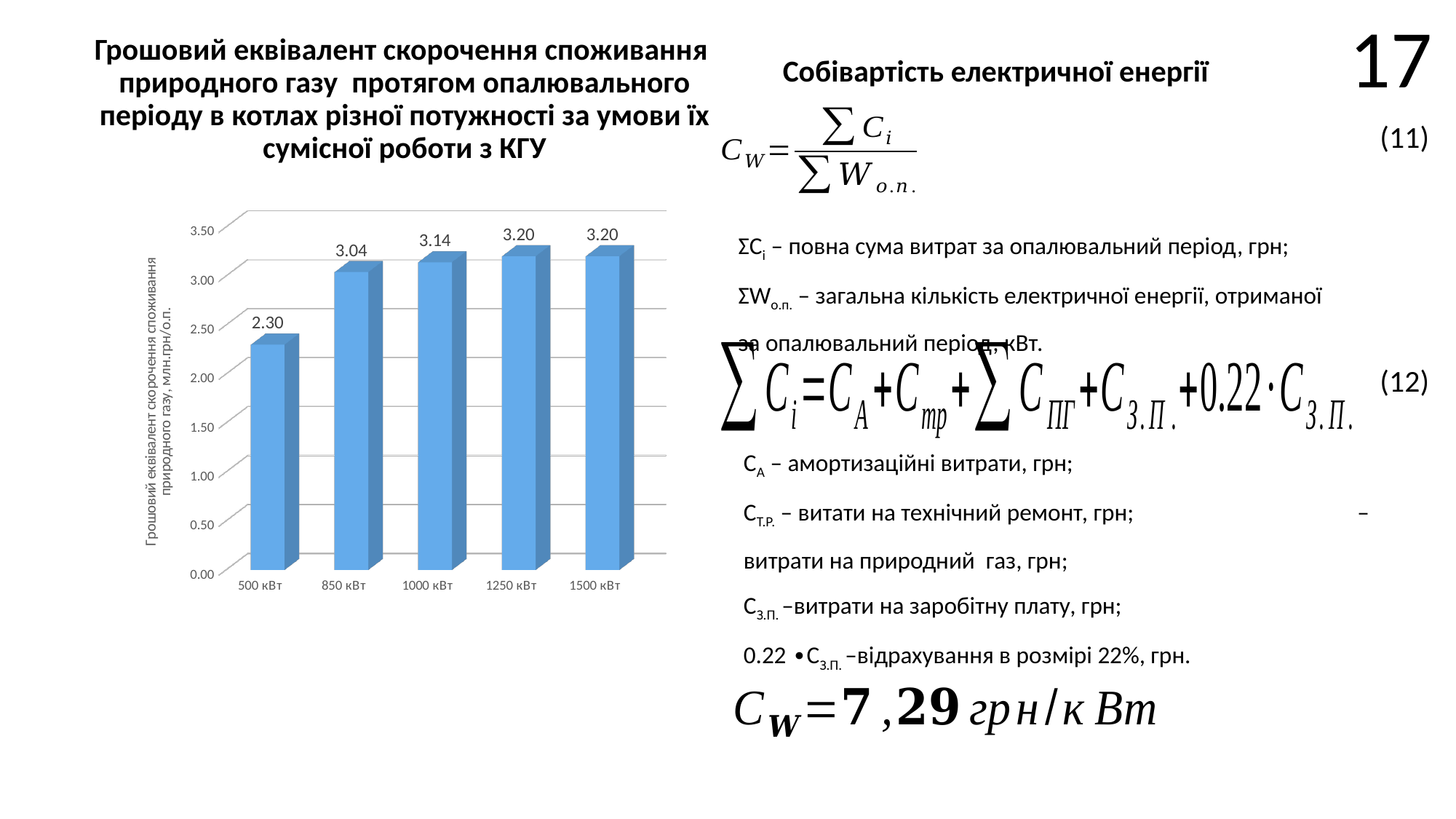
What is the difference between the values for 1250 кВт and 1000 кВт? 0.06 What is the value for 1250 кВт? 3.20 What kind of chart is shown on the slide? bar chart Which category has the lowest value? 500 кВт What is the value for 1000 кВт? 3.14 What is the value for 500 кВт? 2.30 What is the value for 850 кВт? 3.04 What is the difference between the values for 850 кВт and 500 кВт? 0.74 Is the value for 500 кВт greater or less than 2.50? less Which is larger, the value for 1000 кВт or the value for 500 кВт? 1000 кВт How many categories are shown on the x axis? 5 Do the values rise or fall from 500 кВт to 1250 кВт? rise